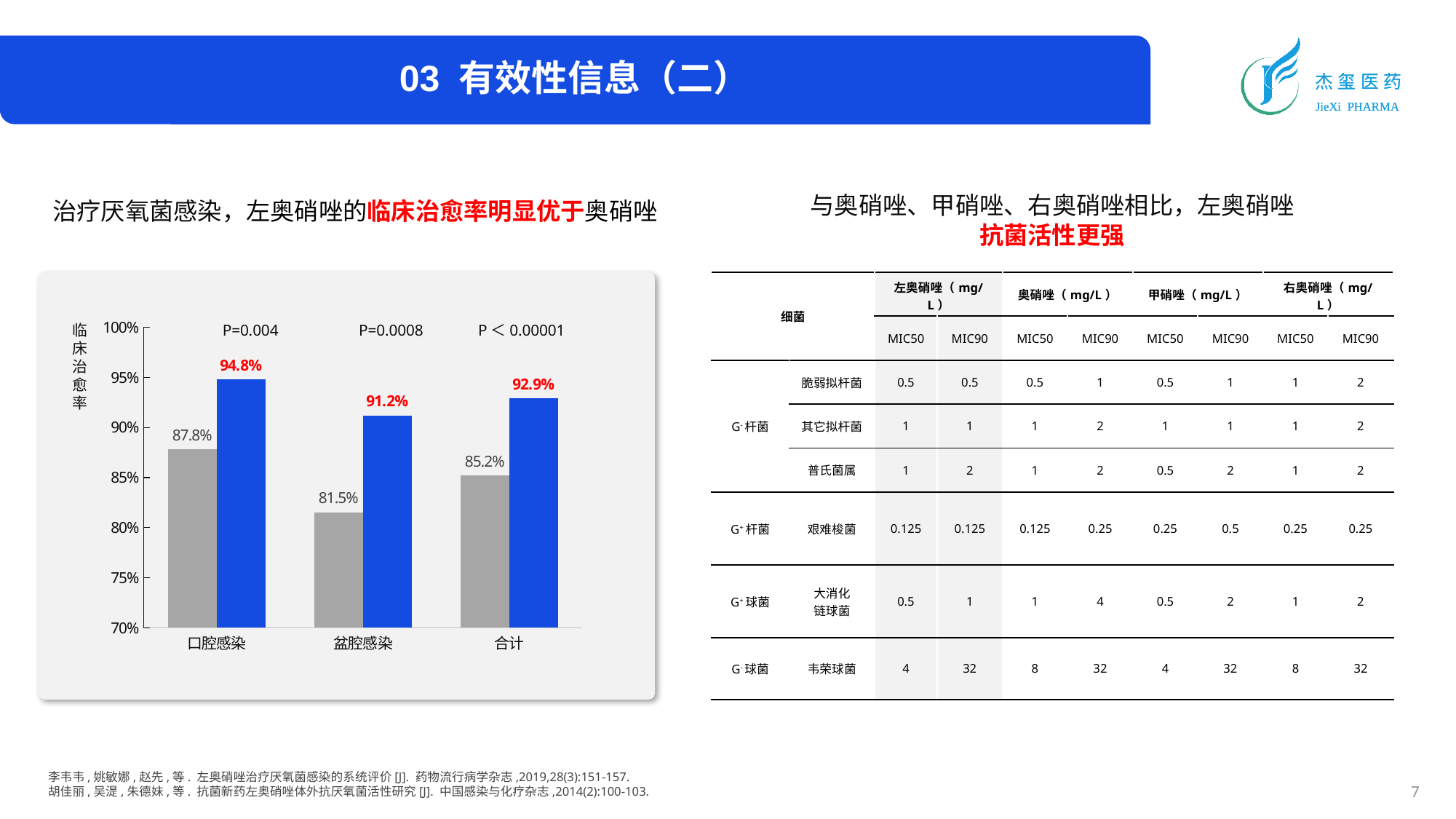
In the bar chart, what is the value of the blue bar for 口腔感染? 94.8% In the bar chart, what is the value of the gray bar for 盆腔感染? 81.5% In the bar chart, which is larger for 口腔感染: the blue bar or the gray bar? the blue bar In the bar chart, what is the value of the blue bar for 合计? 92.9% In the bar chart, what is the difference between the blue bar and the gray bar for 盆腔感染? 9.7% What is the label of the y axis of the bar chart? 临床治愈率 In the bar chart, what P value is printed above the 合计 category? P < 0.00001 In the bar chart, which category has the lowest gray bar? 盆腔感染 In the bar chart, which category has the highest blue bar? 口腔感染 In the bar chart, what is the value of the gray bar for 合计? 85.2% What type of chart is shown on the left side of the slide? bar chart How many categories are shown on the x axis of the bar chart? 3